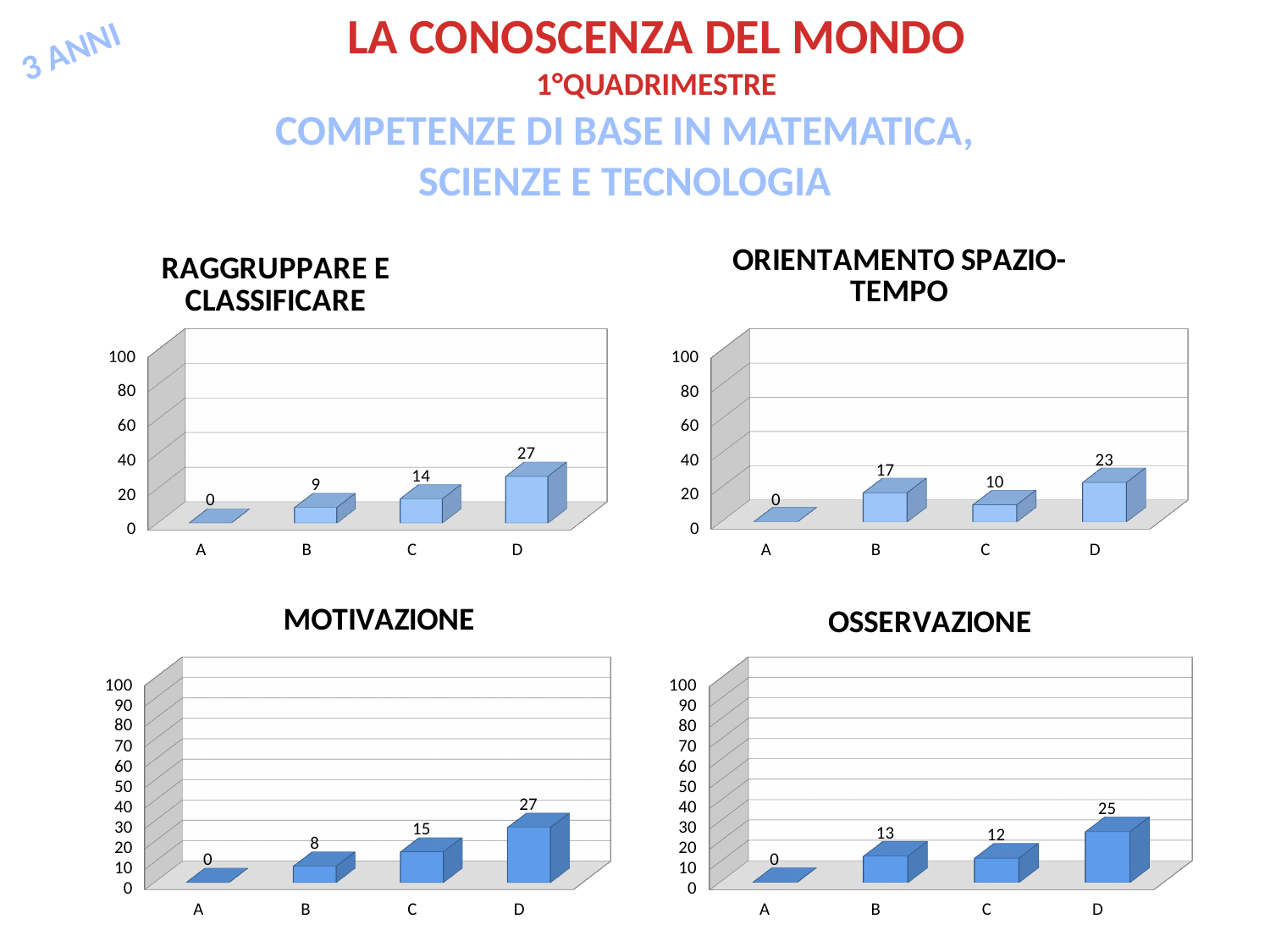
In the RAGGRUPPARE E CLASSIFICARE chart, what is the value for D? 27 How many categories are shown in the RAGGRUPPARE E CLASSIFICARE chart? 4 In the ORIENTAMENTO SPAZIO-TEMPO chart, what is the value for B? 17 In the MOTIVAZIONE chart, is the value for D greater or less than 20? greater In the OSSERVAZIONE chart, which category has the highest value? D In the MOTIVAZIONE chart, what is the value for C? 15 How many charts are shown on the slide? 4 In the ORIENTAMENTO SPAZIO-TEMPO chart, which category has the lowest value? A What kind of chart is the OSSERVAZIONE chart? bar chart In the ORIENTAMENTO SPAZIO-TEMPO chart, which is larger, the value for B or the value for C? B In the MOTIVAZIONE chart, do the values rise or fall from A to D? rise In the OSSERVAZIONE chart, what is the difference between the values for D and B? 12